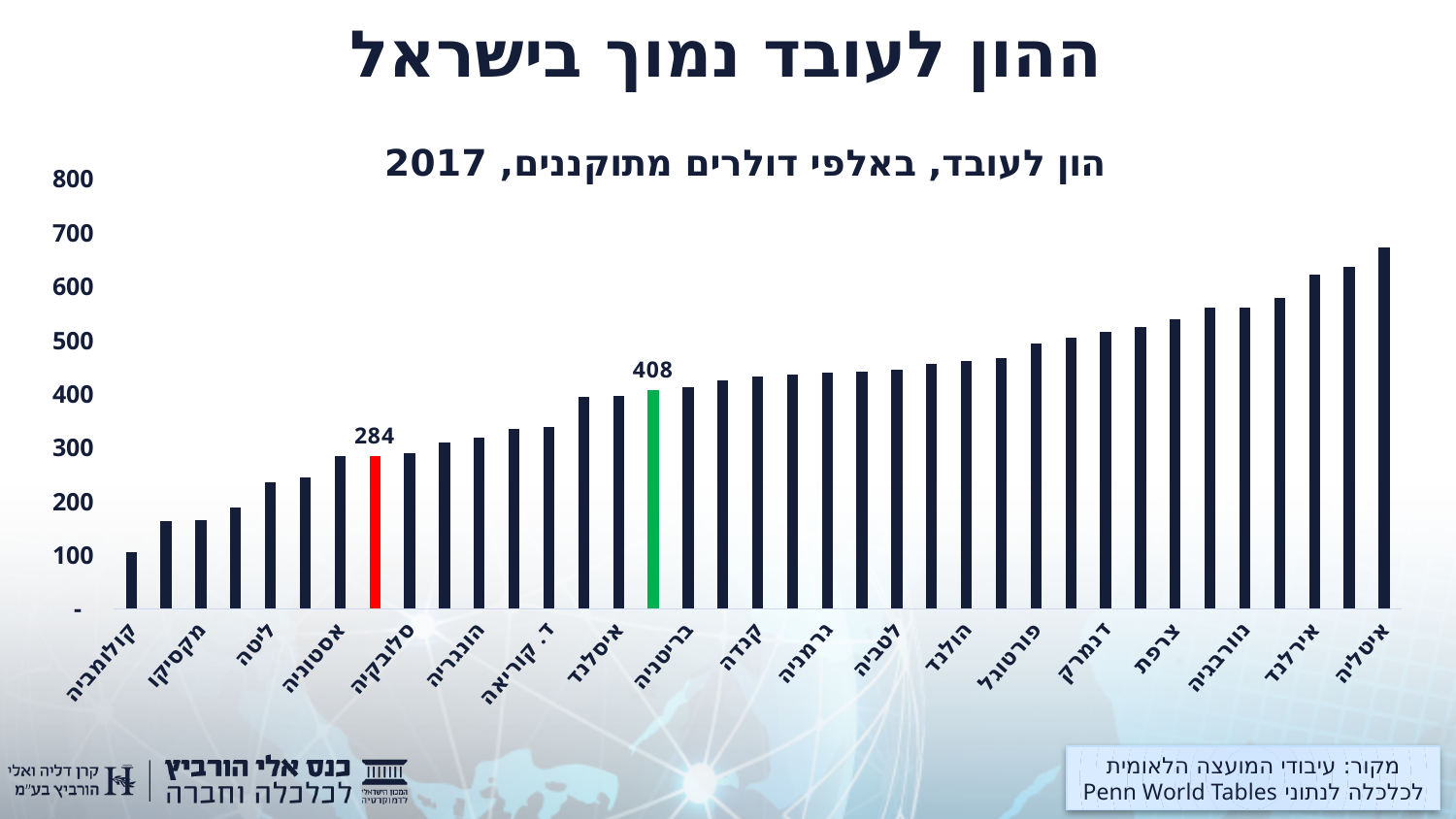
Which is larger, the red bar or the green bar? the green bar Do the bar values rise or fall from left to right along the x axis? rise What value is printed above the green bar? 408 What year does the chart subtitle say the data is for? 2017 Is the value for קולומביה greater or less than 200? less What kind of chart is shown on the slide? bar chart Which country has the highest capital per worker in the chart? איטליה Which country has the lowest capital per worker in the chart? קולומביה Is the value for איטליה greater or less than 600? greater What is the highest value shown on the vertical axis? 800 What is the difference between the green bar's value (408) and the red bar's value (284)? 124 What value is printed above the red bar? 284